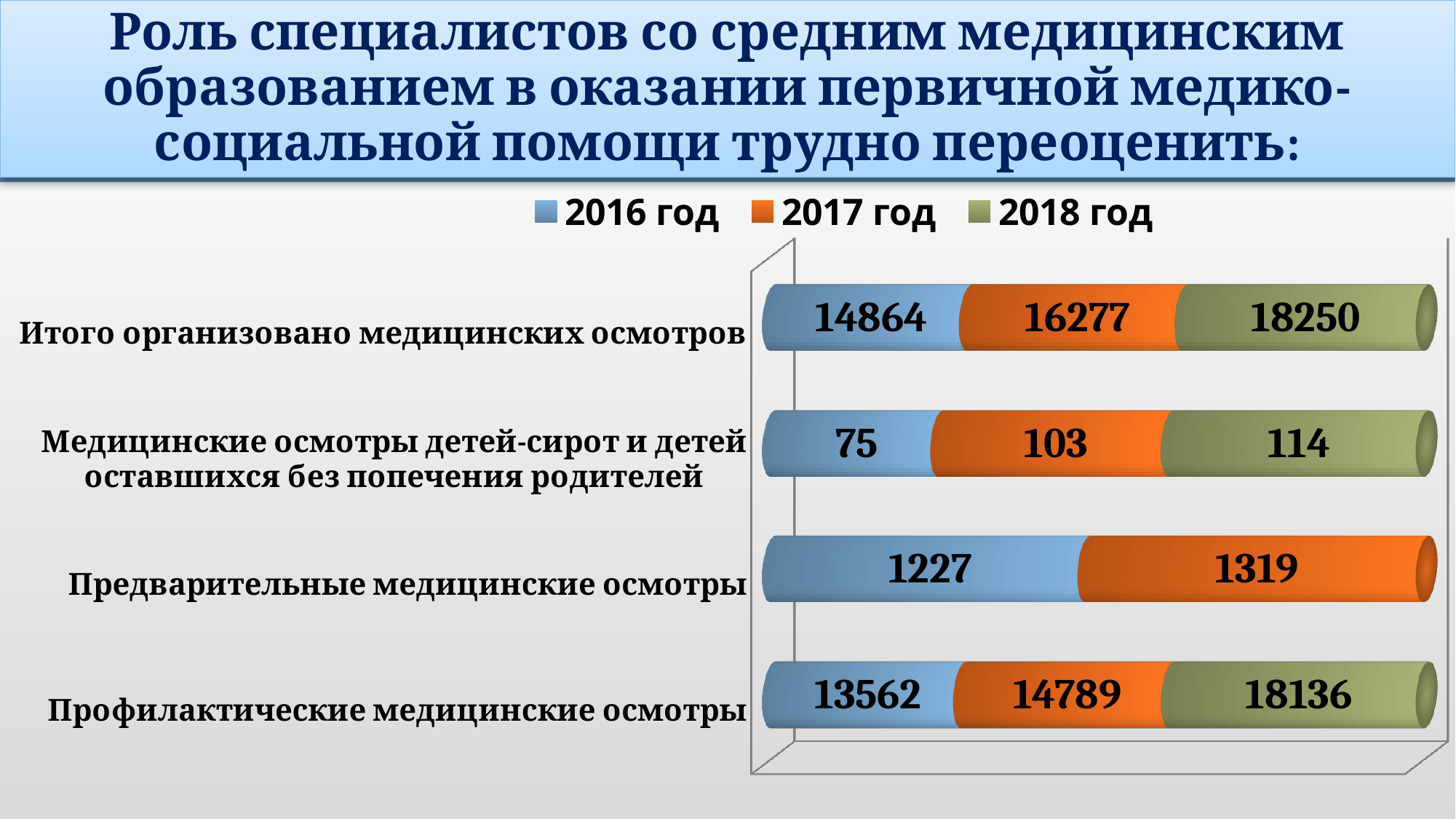
Do the values for Профилактические медицинские осмотры rise or fall from 2016 год to 2018 год? rise What is the value for 2016 год for Медицинские осмотры детей-сирот и детей оставшихся без попечения родителей? 75 How many categories are shown on the chart? 4 Which year has the highest value for Итого организовано медицинских осмотров? 2018 год What kind of chart is shown on the slide? bar chart Which is larger: the 2017 год value for Итого организовано медицинских осмотров or the 2017 год value for Профилактические медицинские осмотры? Итого организовано медицинских осмотров Which year has the lowest value for Медицинские осмотры детей-сирот и детей оставшихся без попечения родителей? 2016 год What is the value for 2017 год for Предварительные медицинские осмотры? 1319 What is the value for 2018 год for Итого организовано медицинских осмотров? 18250 What is the value for 2017 год for Профилактические медицинские осмотры? 14789 What is the difference between the 2018 год and 2016 год values for Профилактические медицинские осмотры? 4574 How many series does the legend list? 3